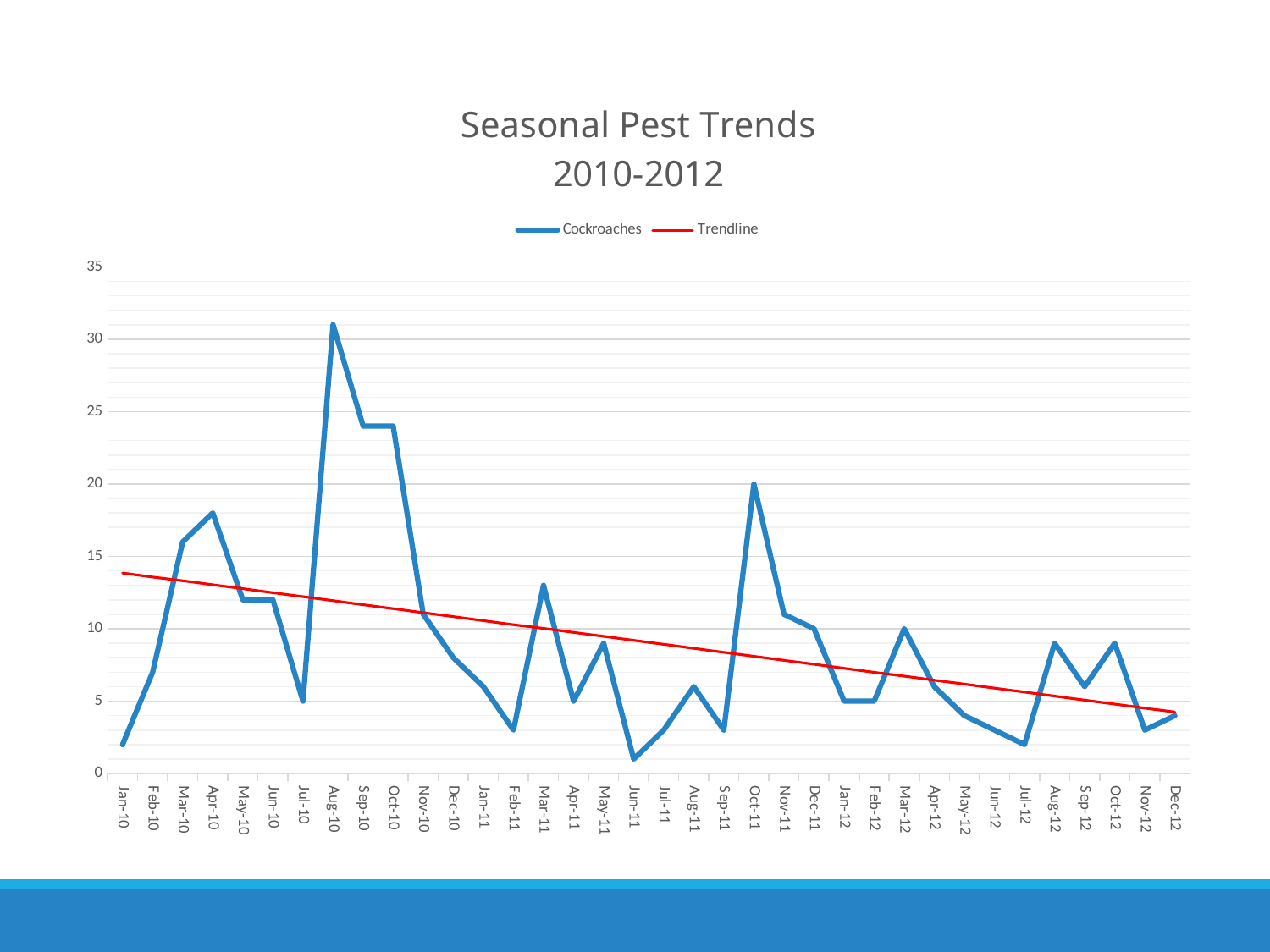
Does the Trendline rise or fall from Jan-10 to Dec-12? fall In which month does the Cockroaches series reach its highest value? Aug-10 In which month does the Cockroaches series reach its lowest value? Jun-11 How many series does the legend list? 2 Which month has the higher Cockroaches value, Aug-10 or Oct-11? Aug-10 Is the Cockroaches value for Apr-10 greater or less than 15? greater What colour is the Trendline series drawn in? red Is the Cockroaches value for Jun-11 greater or less than 5? less How many months are plotted along the x axis? 36 Is the Cockroaches value for Aug-10 greater or less than 25? greater What kind of chart is shown on the slide? line chart What is the title of the chart? Seasonal Pest Trends 2010-2012